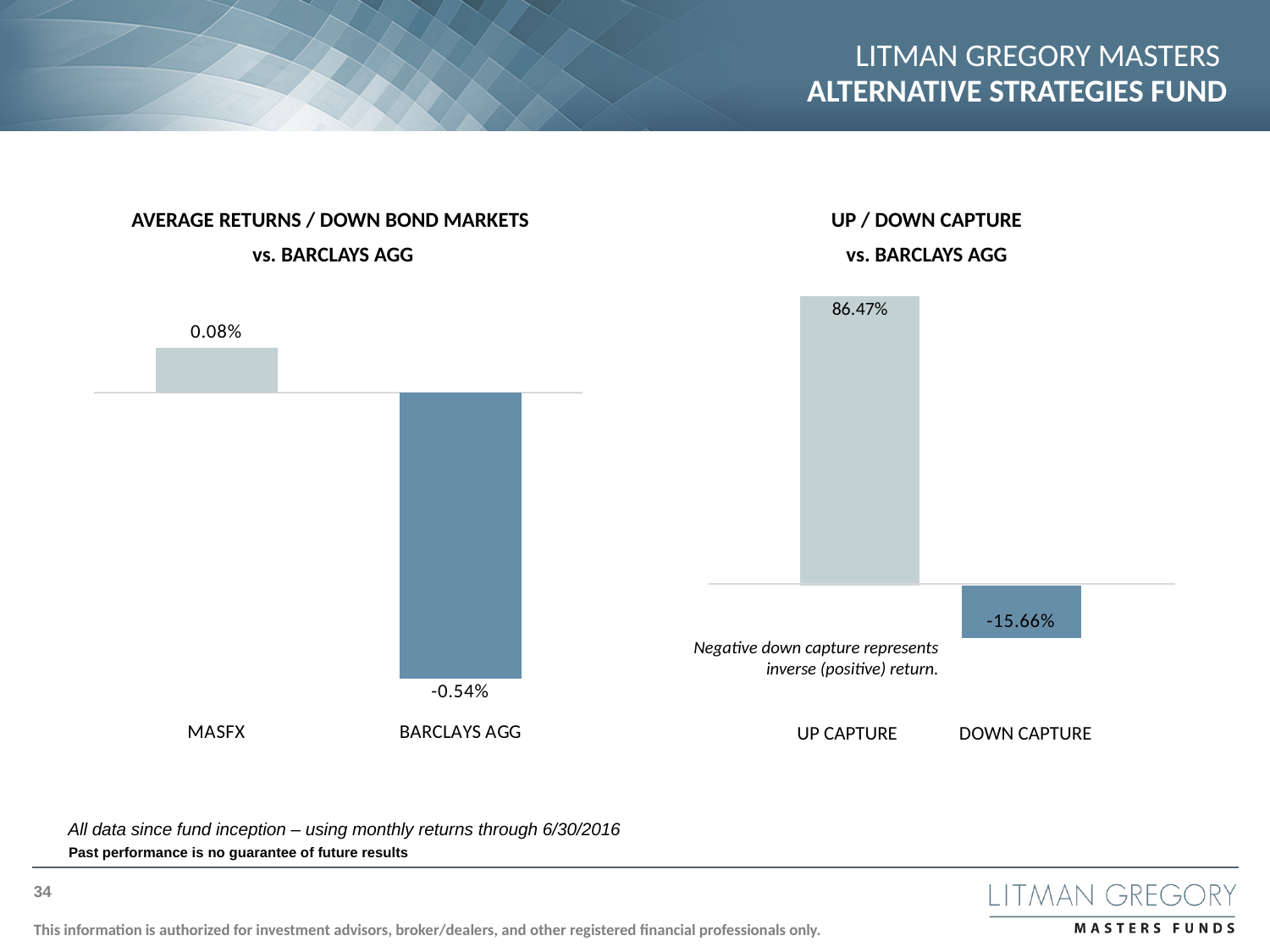
In the 'Up / Down Capture vs. Barclays Agg' chart, is the value for Up Capture larger or smaller than the value for Down Capture? larger In the 'Up / Down Capture vs. Barclays Agg' chart, what is the value for Down Capture? -15.66% In the 'Average Returns / Down Bond Markets vs. Barclays Agg' chart, which category has the higher value? MASFX In the 'Up / Down Capture vs. Barclays Agg' chart, which category has the lowest value? DOWN CAPTURE In the 'Average Returns / Down Bond Markets vs. Barclays Agg' chart, what is the value for MASFX? 0.08% In the 'Average Returns / Down Bond Markets vs. Barclays Agg' chart, which category has the lowest value? BARCLAYS AGG In the 'Up / Down Capture vs. Barclays Agg' chart, what is the difference between the Up Capture value and the Down Capture value? 102.13% How many categories are shown in the 'Average Returns / Down Bond Markets vs. Barclays Agg' chart? 2 In the 'Up / Down Capture vs. Barclays Agg' chart, what is the value for Up Capture? 86.47% In the 'Average Returns / Down Bond Markets vs. Barclays Agg' chart, what is the value for Barclays Agg? -0.54% In the 'Average Returns / Down Bond Markets vs. Barclays Agg' chart, what is the difference between the MASFX value and the Barclays Agg value? 0.62% What type of chart is the 'Up / Down Capture vs. Barclays Agg' chart? bar chart